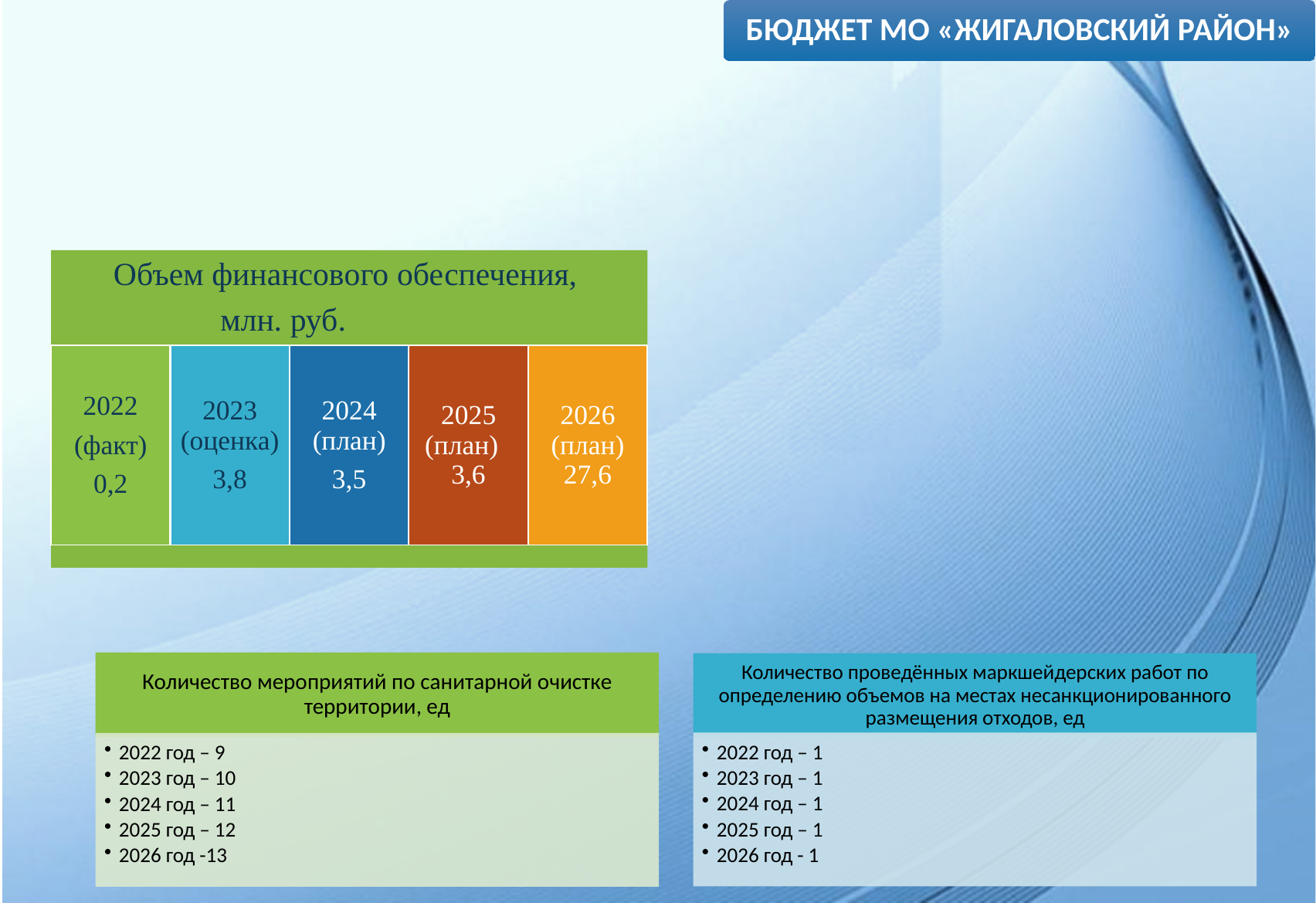
In the 'Объем финансового обеспечения, млн. руб.' graphic, what is the value for 2024 (план)? 3,5 In the 'Объем финансового обеспечения, млн. руб.' graphic, what colour is the 2026 (план) block? Orange In the 'Объем финансового обеспечения, млн. руб.' graphic, which year has the lowest value? 2022 (факт) In the 'Объем финансового обеспечения, млн. руб.' graphic, what is the value for 2023 (оценка)? 3,8 In the 'Объем финансового обеспечения, млн. руб.' graphic, what is the value for 2022 (факт)? 0,2 In the 'Объем финансового обеспечения, млн. руб.' graphic, what is the difference between the 2023 and 2024 values? 0,3 How many years are shown in the 'Объем финансового обеспечения, млн. руб.' graphic? 5 In the 'Объем финансового обеспечения, млн. руб.' graphic, which is larger: the value for 2025 or the value for 2024? 2025 In the 'Объем финансового обеспечения, млн. руб.' graphic, which year has the highest value? 2026 (план) In the 'Количество мероприятий по санитарной очистке территории, ед' box, do the values rise or fall from 2022 to 2026? Rise In the 'Количество мероприятий по санитарной очистке территории, ед' box, what is the value for 2025? 12 In the 'Объем финансового обеспечения, млн. руб.' graphic, what is the value for 2026 (план)? 27,6